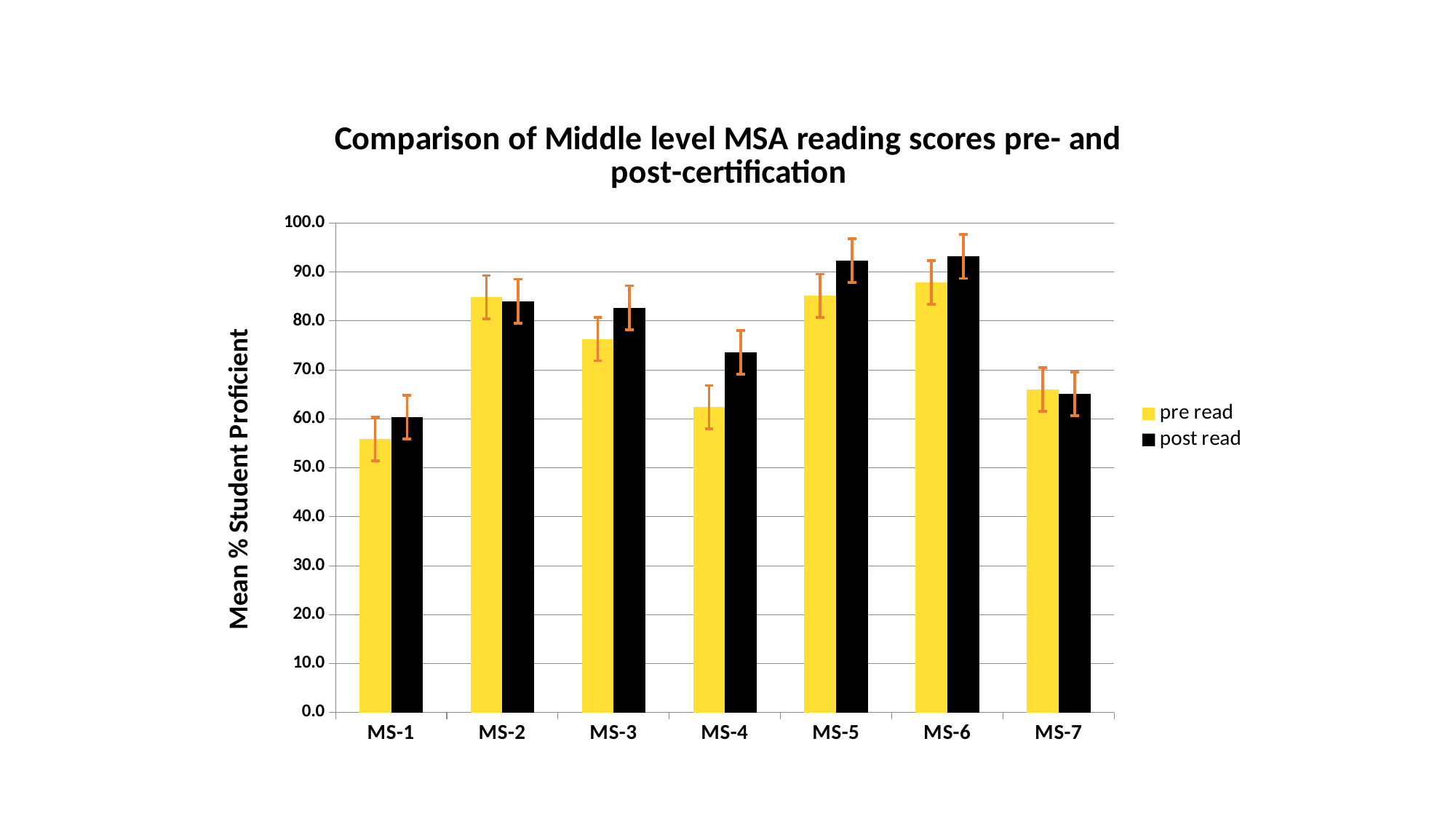
What is the label of the y axis? Mean % Student Proficient What kind of chart is shown on the slide? bar chart For MS-3, which is larger: the pre read value or the post read value? post read Which school has the lowest post read value? MS-1 How many schools (categories) are shown on the x axis? 7 Is the pre read value for MS-1 greater or less than 60? less Is the post read value for MS-5 greater or less than 90? greater Is the post read value for MS-4 greater or less than 70? greater Which school has the lowest pre read value? MS-1 How many series does the legend list? 2 For MS-4, which is larger: the pre read value or the post read value? post read